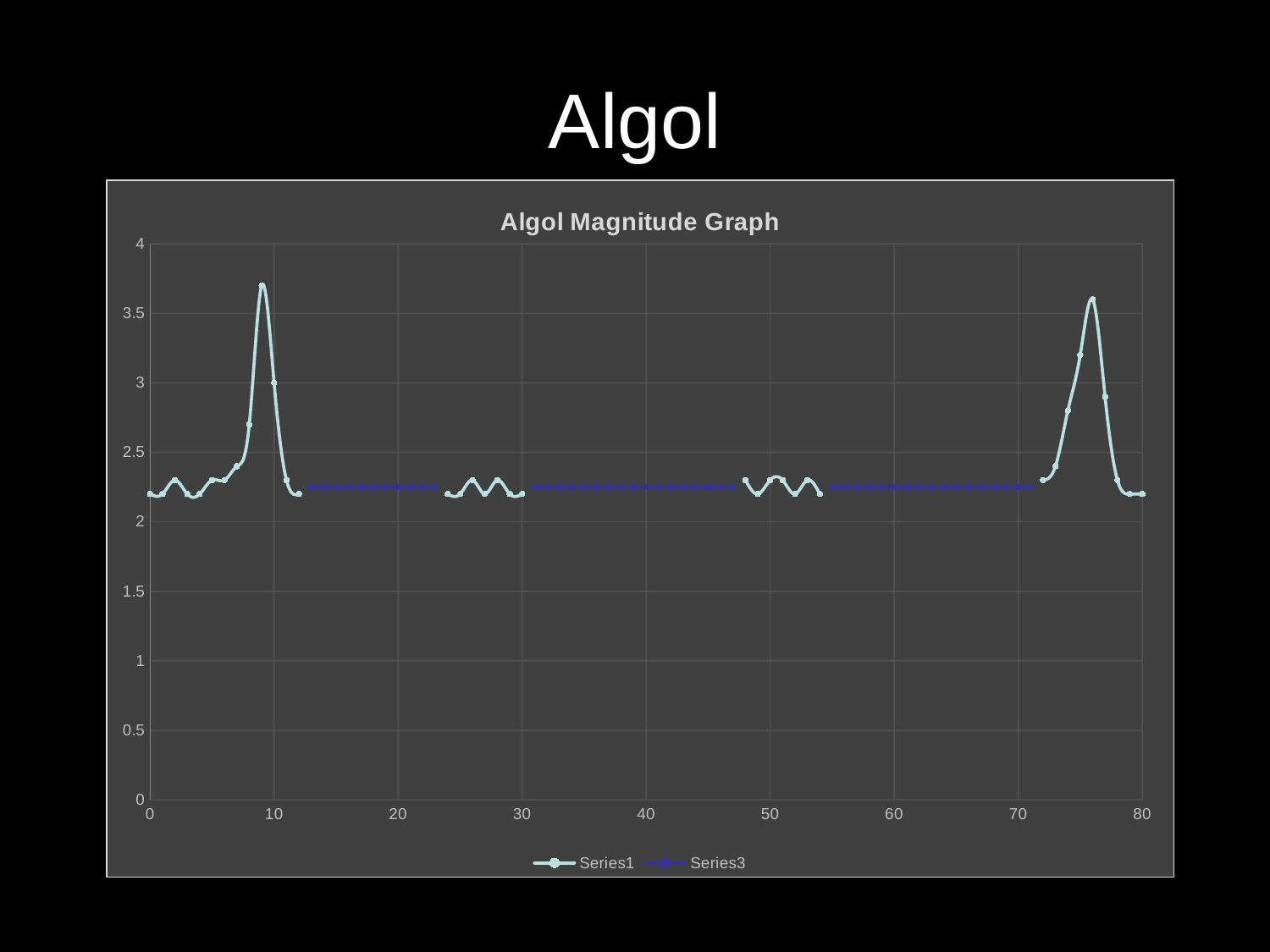
What type of chart is shown on the slide? line chart Is the highest value reached by Series1 greater or less than 3.5? greater What is the title of the chart? Algol Magnitude Graph Is the value of Series1 at x = 76 greater or less than 3? greater Is the value of Series3 at x = 40 greater or less than 2.5? less How many series does the legend list? 2 Is the value of Series1 at x = 9 larger or smaller than the value of Series3 at x = 20? larger What are the names of the series listed in the legend? Series1 and Series3 Which series reaches the highest value on the chart? Series1